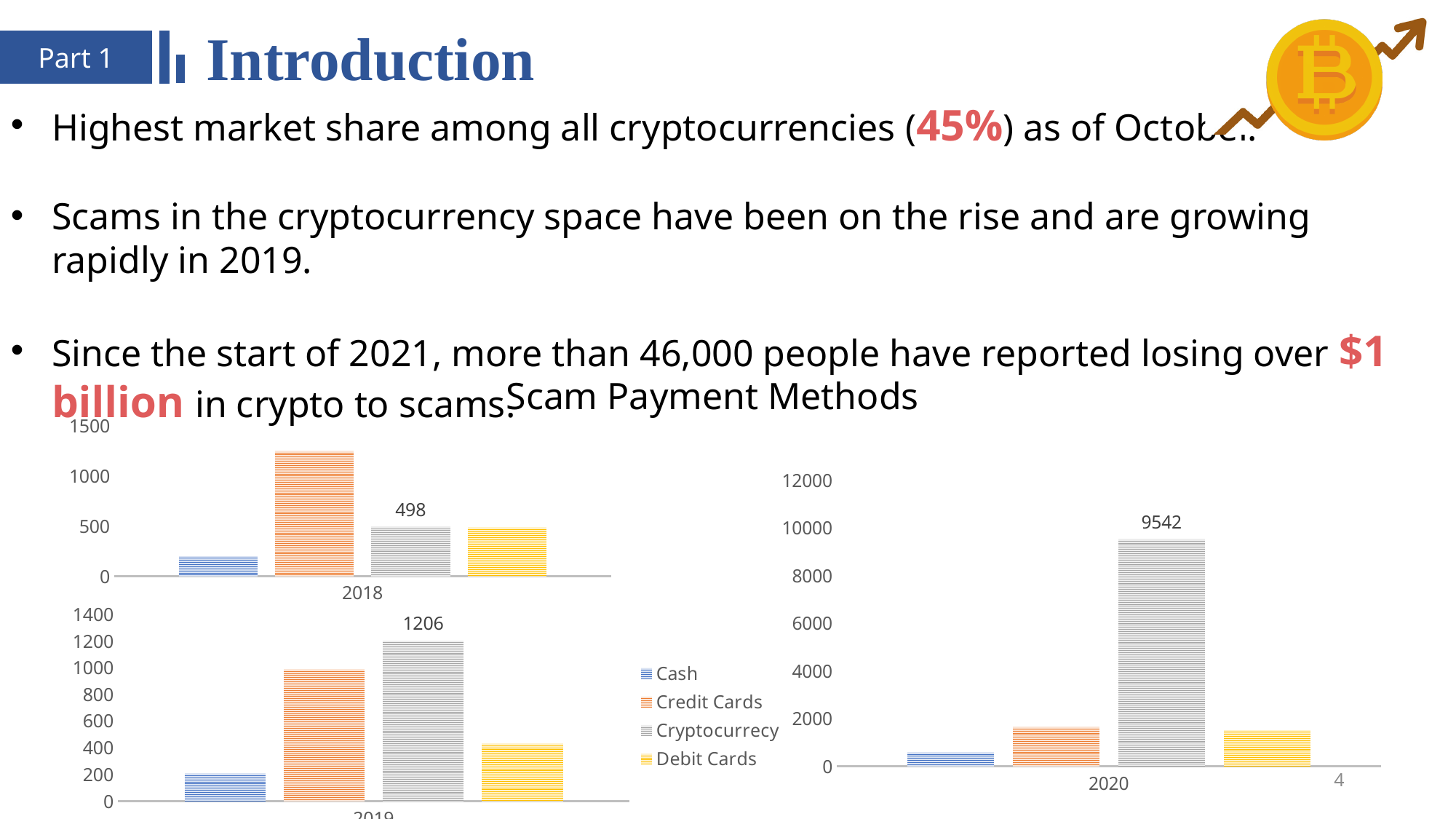
What is the difference between the Cryptocurrency value in the 2020 chart and the Cryptocurrency value in the 2019 chart? 8336 In the 2020 chart, what is the value for Cryptocurrency? 9542 In the 2020 chart, which payment method has the highest value? Cryptocurrency In the 2019 chart, what is the value for Cryptocurrency? 1206 In the 2018 chart, is the value for Credit Cards greater or less than 1000? greater In the 2018 chart, what is the value for Cryptocurrency? 498 In the 2019 chart, which is larger, the value for Cryptocurrency or the value for Credit Cards? Cryptocurrency In the 2018 chart, which payment method has the highest value? Credit Cards In the 2019 chart, which payment method has the lowest value? Cash How many series does the legend list? 4 What kind of chart is the 2020 chart? bar chart In the 2020 chart, is the value for Cash greater or less than 2000? less